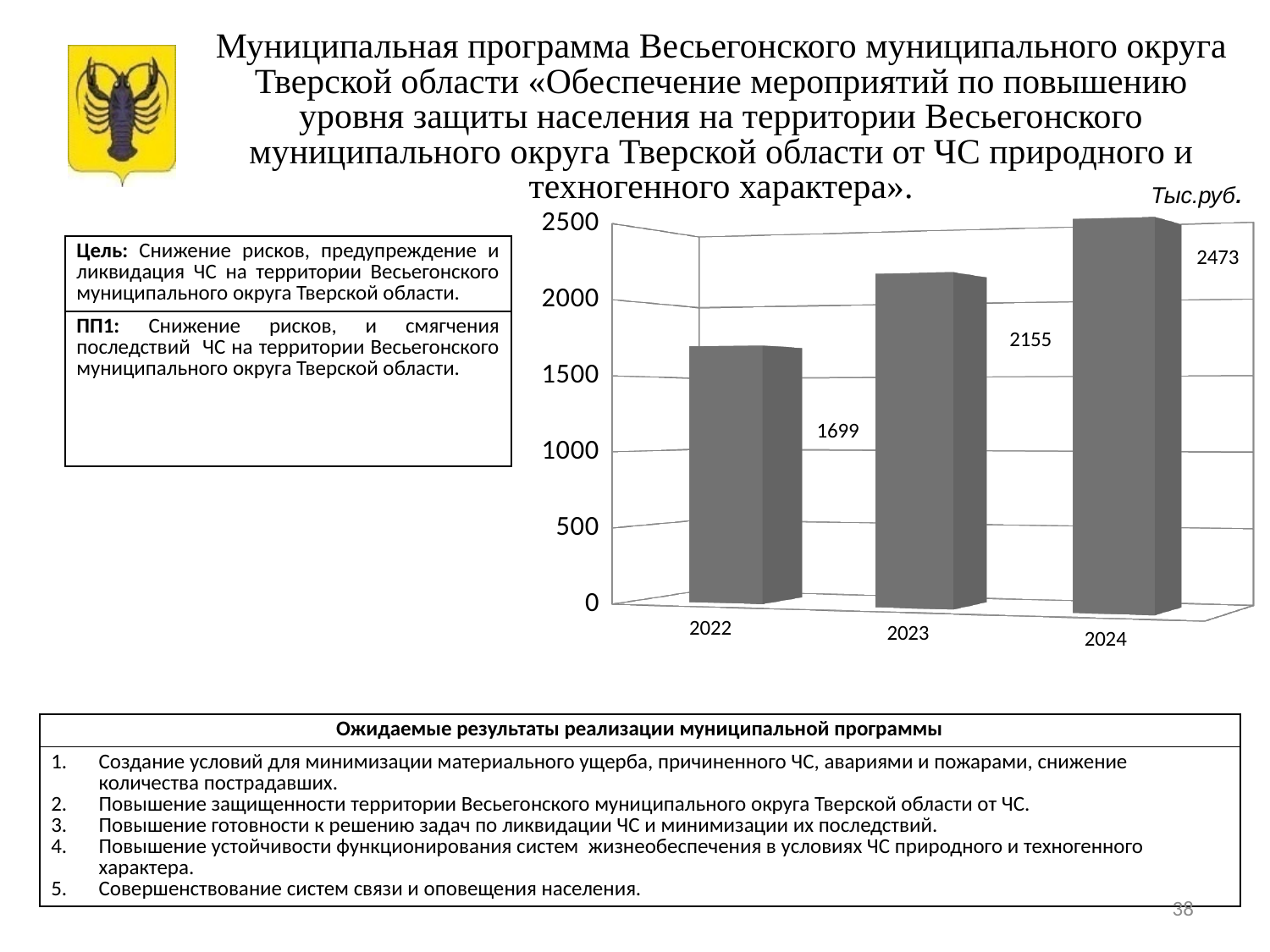
What is the value for 2024 on the chart? 2473 How many years are shown on the chart? 3 Which is larger, the value for 2023 or the value for 2024? 2024 What is the difference between the values for 2024 and 2022? 774 What kind of chart is shown on the slide? bar chart Do the values rise or fall from 2022 to 2024? rise Which year has the lowest value on the chart? 2022 What is the value for 2022 on the chart? 1699 What is the difference between the values for 2023 and 2022? 456 Is the value for 2022 greater or less than 2000? less What is the value for 2023 on the chart? 2155 Which year has the highest value on the chart? 2024